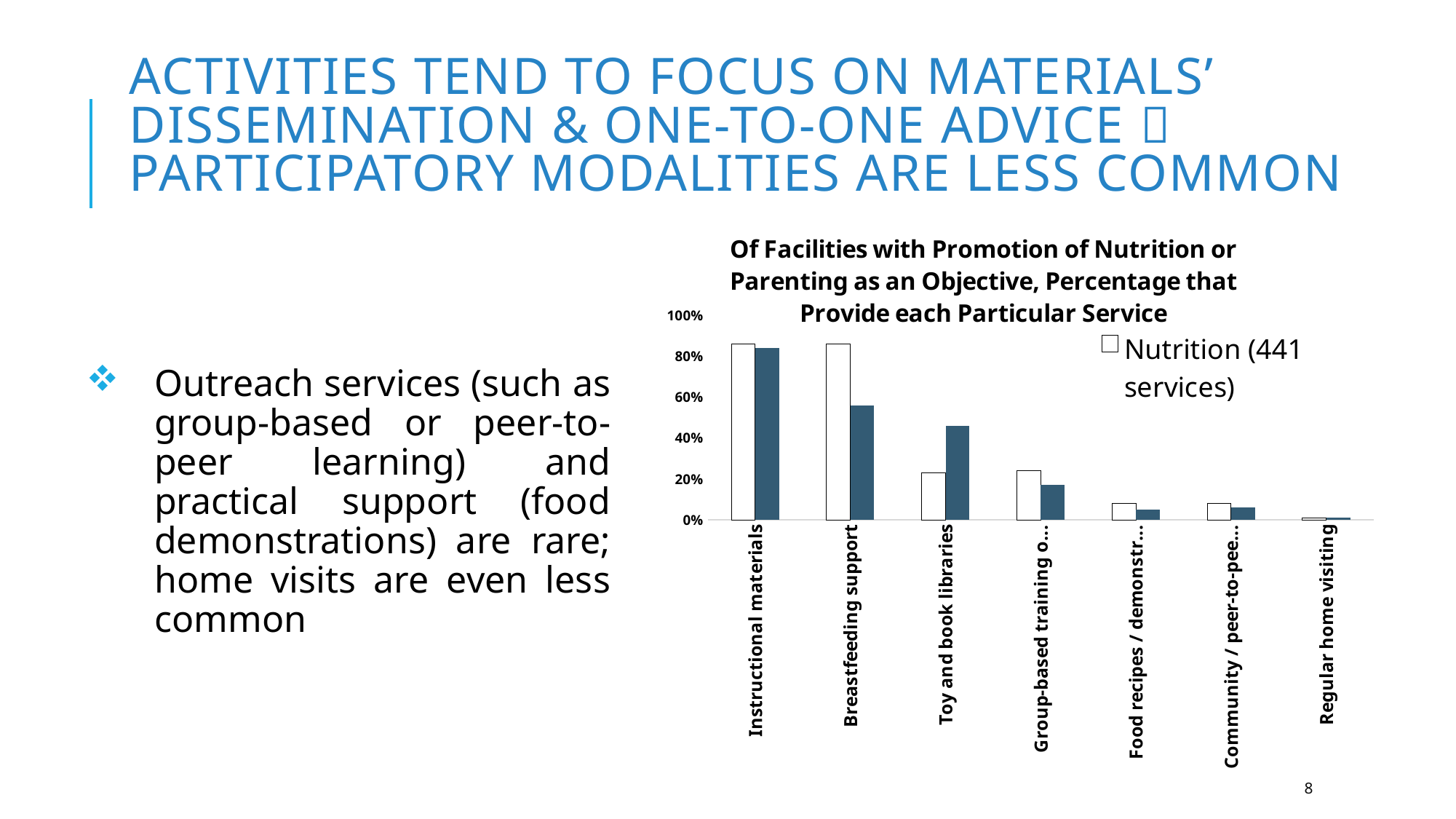
Which category has the highest value for the dark blue series? Instructional materials Is the dark blue series value for Breastfeeding support greater or less than 60%? less For Toy and book libraries, which bar is taller: the Nutrition (441 services) bar or the dark blue bar? the dark blue bar For Breastfeeding support, which bar is taller: the Nutrition (441 services) bar or the dark blue bar? the Nutrition (441 services) bar Which series name is shown in the chart's legend? Nutrition (441 services) Is the Nutrition (441 services) value for Toy and book libraries greater or less than 40%? less What kind of chart is shown on the slide? bar chart Is the dark blue series value for Toy and book libraries greater or less than 40%? greater How many categories are shown on the x axis of the chart? 7 Which category has the lowest values in the chart? Regular home visiting Do the dark blue series values rise or fall from left to right across the categories? fall